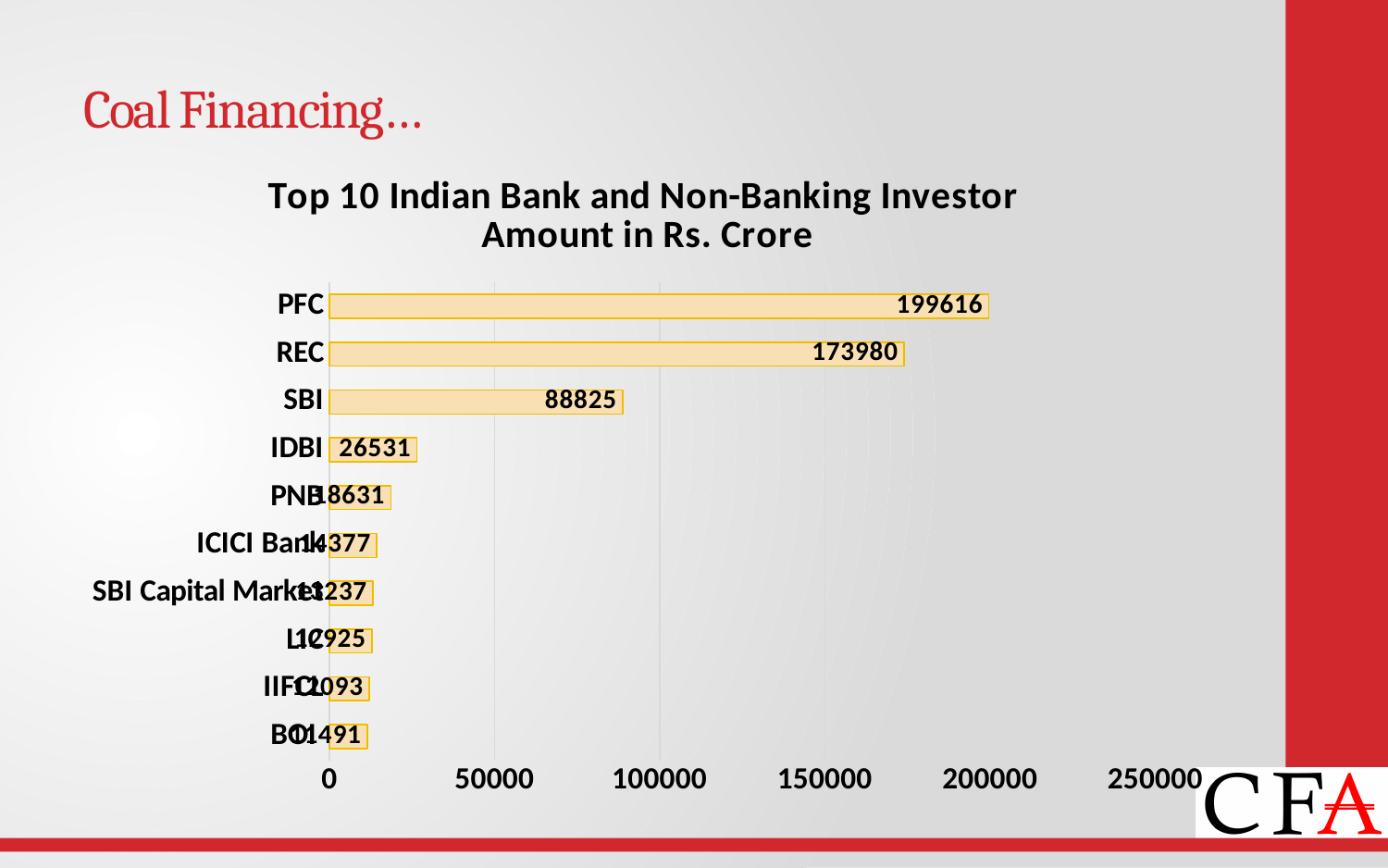
Which has a larger value, SBI or IDBI? SBI What type of chart is shown on the slide? bar chart What is the value for IDBI? 26531 What is the value for SBI? 88825 What is the difference between the values for REC and SBI? 85155 What is the value for REC? 173980 What is the difference between the values for PFC and REC? 25636 How many categories are shown in the chart? 10 Is the value for BOI greater or less than 50000? less What is the title of the chart? Top 10 Indian Bank and Non-Banking Investor Amount in Rs. Crore What is the value for PFC? 199616 Which category has the highest value? PFC